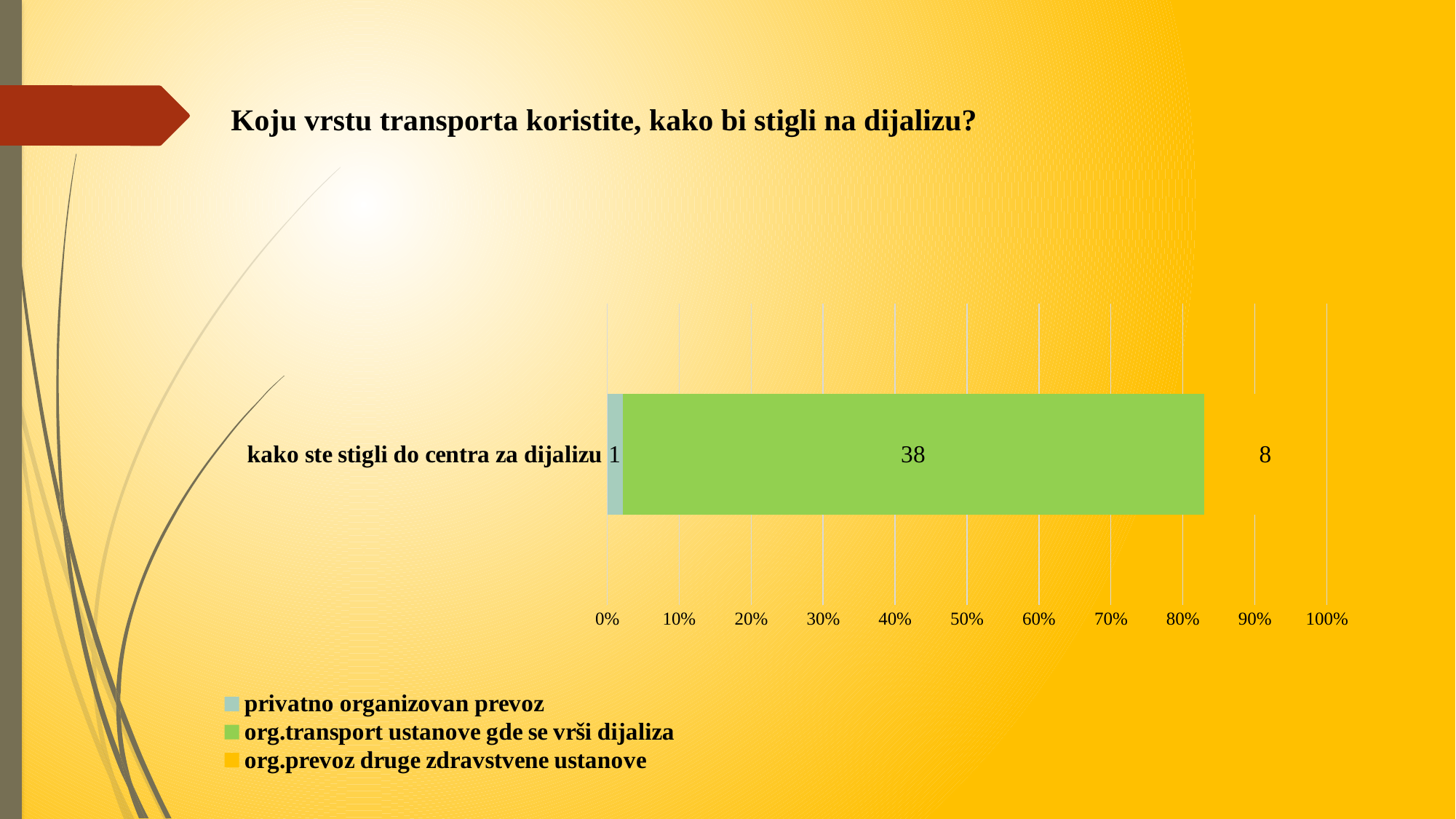
What is the title of the slide above the chart? Koju vrstu transporta koristite, kako bi stigli na dijalizu? What value is shown for 'org.prevoz druge zdravstvene ustanove'? 8 What value is shown for 'privatno organizovan prevoz'? 1 Which series has the lowest value? privatno organizovan prevoz What is the difference between the values for 'org.transport ustanove gde se vrši dijaliza' and 'org.prevoz druge zdravstvene ustanove'? 30 How many series does the legend list? 3 How many categories are shown on the vertical axis? 1 What value is shown for 'org.transport ustanove gde se vrši dijaliza'? 38 What is the total of the three values in the stacked bar? 47 Which is larger: the value for 'org.prevoz druge zdravstvene ustanove' or for 'privatno organizovan prevoz'? org.prevoz druge zdravstvene ustanove Which series has the highest value? org.transport ustanove gde se vrši dijaliza What kind of chart is shown on the slide? Stacked bar chart